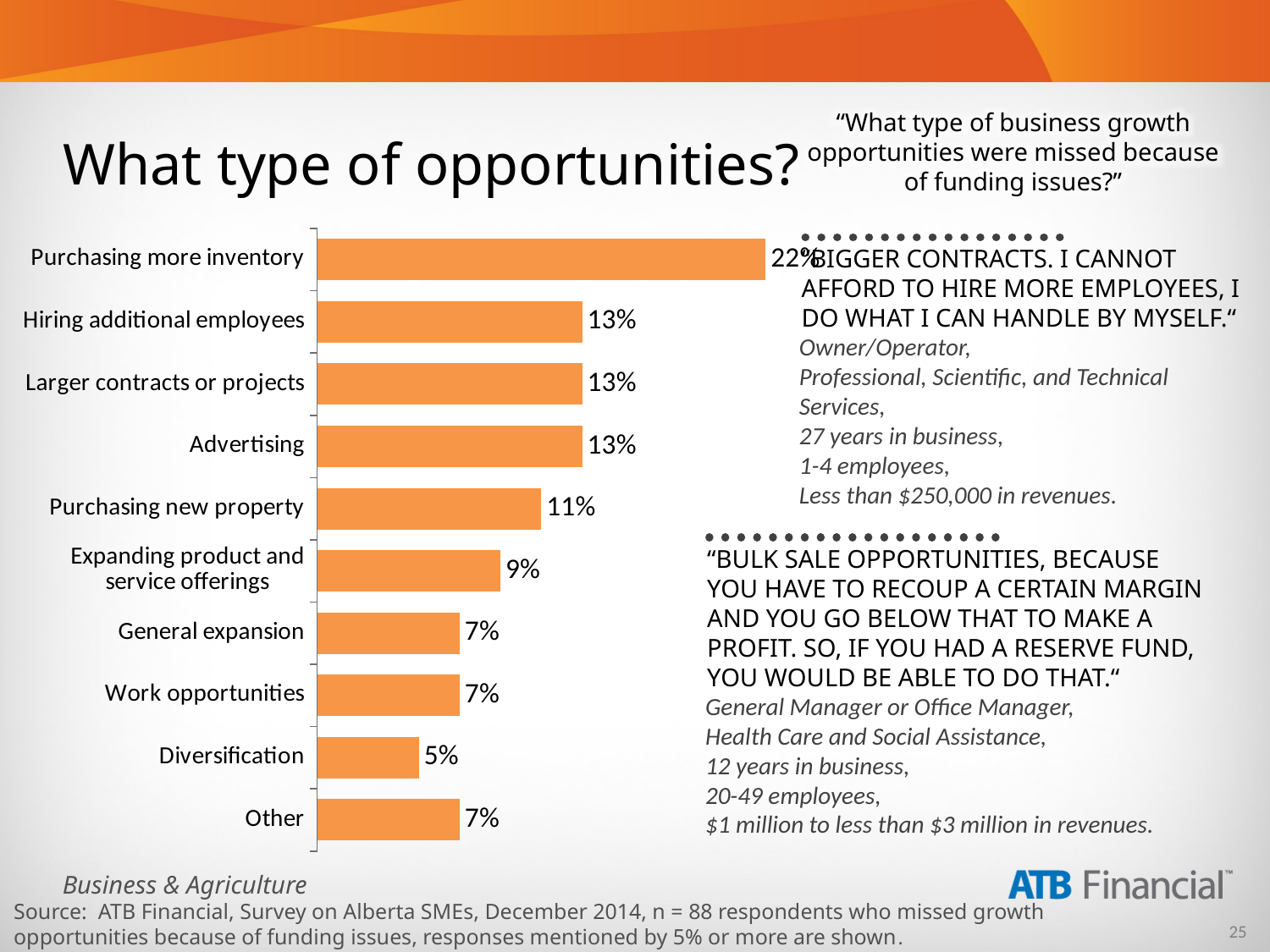
What is the value for Purchasing new property? 11% What kind of chart is shown on the slide? Bar chart What is the difference between the values for Purchasing more inventory and Hiring additional employees? 9% What is the difference between the values for Purchasing new property and Diversification? 6% Which category has the highest value in the chart? Purchasing more inventory What percentage is shown for Purchasing more inventory? 22% Which is larger, the value for Advertising or the value for General expansion? Advertising What percentage is shown for Expanding product and service offerings? 9% How many categories are shown in the bar chart? 10 What is the title of the slide containing the chart? What type of opportunities? Which category has the lowest value in the chart? Diversification What is the value for Diversification? 5%